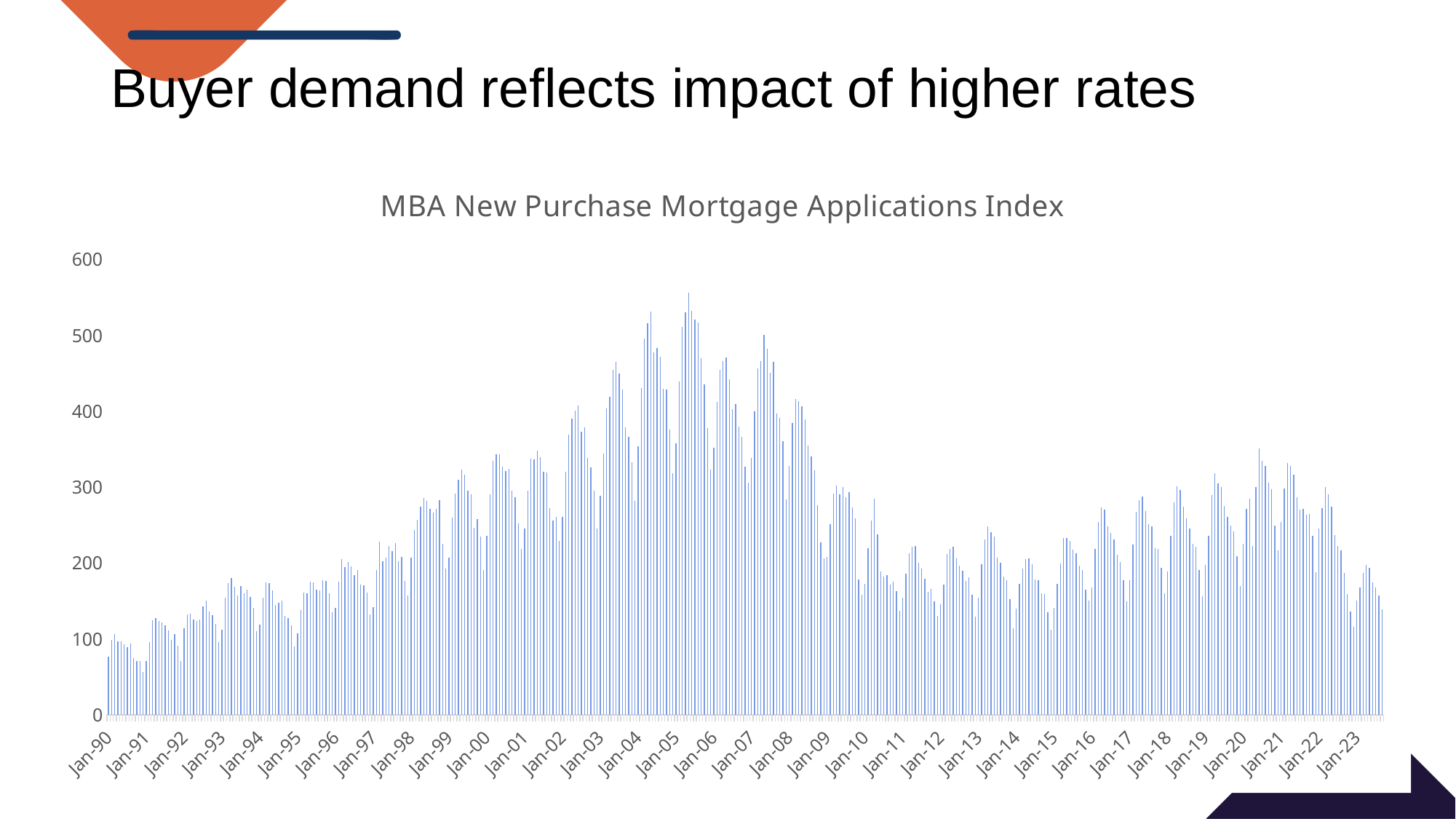
Is the value for Jan-05 greater or less than 300? greater Is the value for Jan-23 greater or less than 300? less Which is larger, the value for Jan-05 or the value for Jan-90? Jan-05 What is the title of the chart? MBA New Purchase Mortgage Applications Index What kind of chart is shown on the slide? bar chart Is the value for Jan-90 greater or less than 100? less What are the first and last labels on the x axis? Jan-90 and Jan-23 In which year do the bars reach their highest level? 2005 Do the values generally rise or fall from Jan-21 to Jan-23? fall Do the values generally rise or fall from Jan-90 to Jan-05? rise